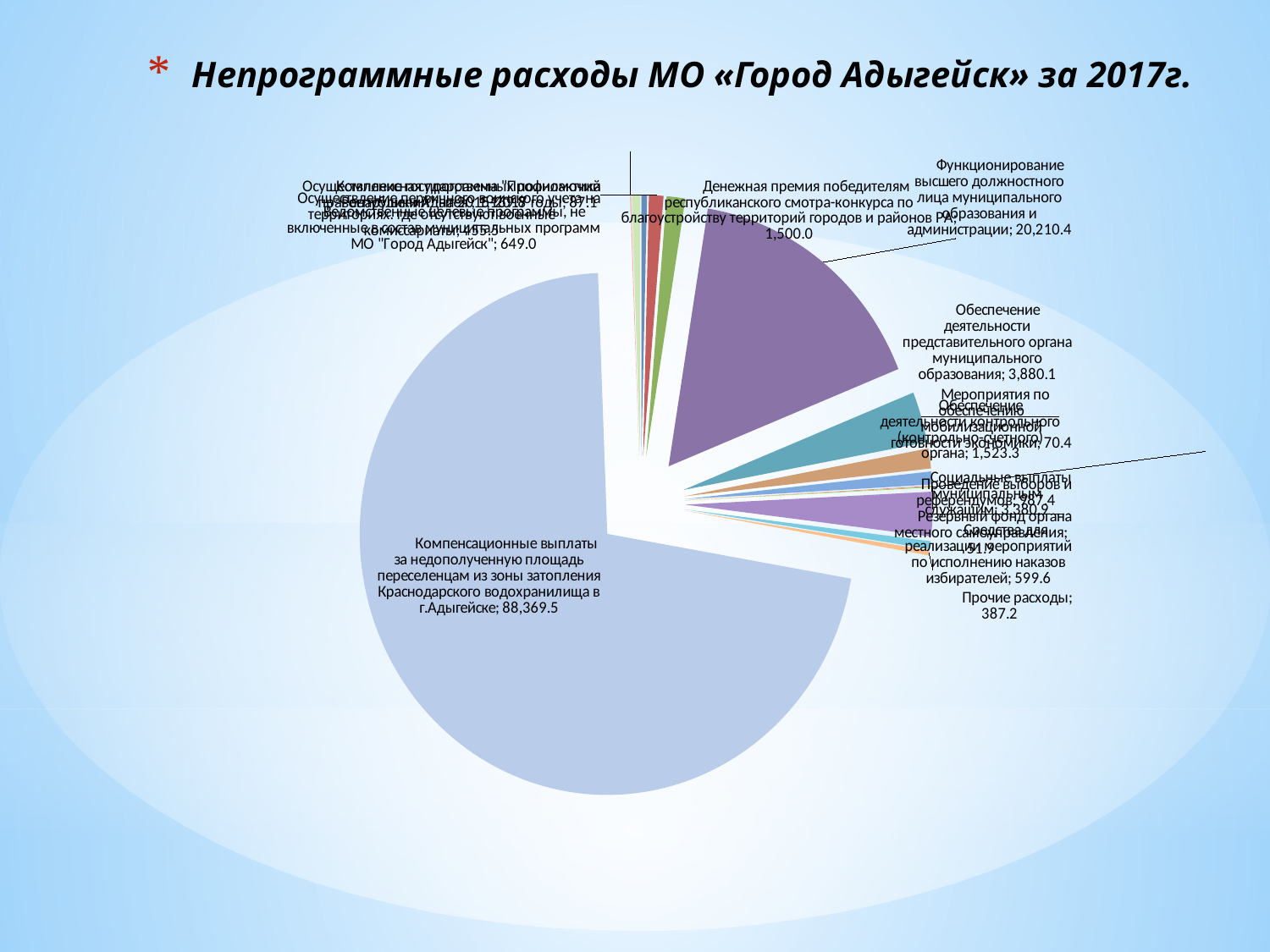
What is the value for Прочие расходы? 387.2 What is the value for Денежная премия победителям республиканского смотра-конкурса по благоустройству территорий городов и районов РА? 1,500.0 What is the difference between the value for Компенсационные выплаты за недополученную площадь переселенцам (88,369.5) and Функционирование высшего должностного лица муниципального образования и администрации (20,210.4)? 68,159.1 What is the difference between the value for Обеспечение деятельности представительного органа муниципального образования (3,880.1) and Денежная премия победителям республиканского смотра-конкурса (1,500.0)? 2,380.1 What kind of chart is shown on the slide? pie chart What is the value for Компенсационные выплаты за недополученную площадь переселенцам из зоны затопления Краснодарского водохранилища в г.Адыгейске? 88,369.5 Which is larger: Функционирование высшего должностного лица муниципального образования и администрации or Обеспечение деятельности представительного органа муниципального образования? Функционирование высшего должностного лица муниципального образования и администрации Which category has the largest slice of the pie? Компенсационные выплаты за недополученную площадь переселенцам из зоны затопления Краснодарского водохранилища в г.Адыгейске What is the value for Обеспечение деятельности представительного органа муниципального образования? 3,880.1 What is the title of the chart on the slide? Непрограммные расходы МО «Город Адыгейск» за 2017г. What is the value for Средства для реализации мероприятий по исполнению наказов избирателей? 599.6 What is the value for Функционирование высшего должностного лица муниципального образования и администрации? 20,210.4